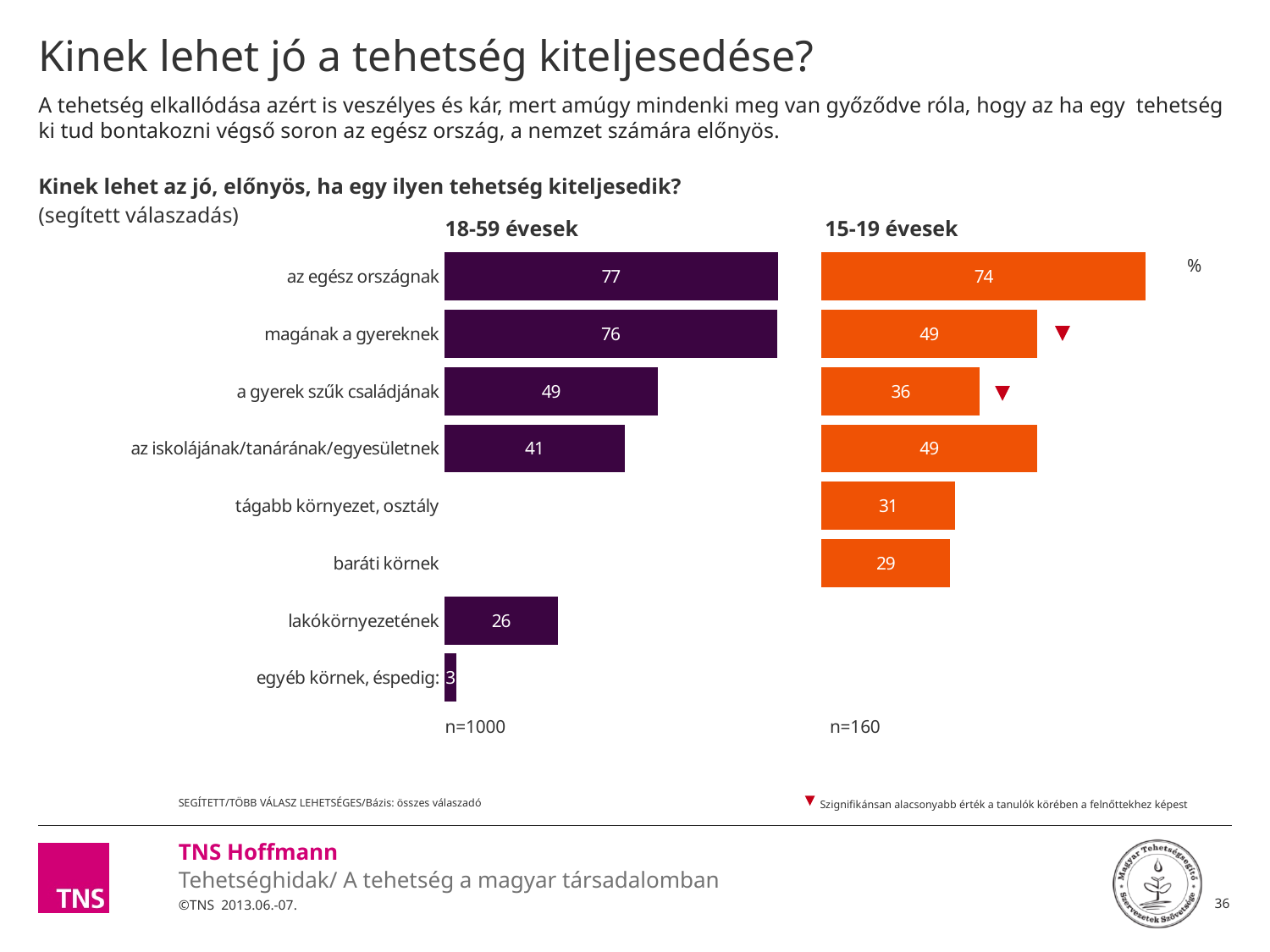
In the 15-19 évesek chart, which category has the highest value? az egész országnak In the 18-59 évesek chart, what is the value for 'az egész országnak'? 77 For 'az iskolájának/tanárának/egyesületnek', which group has the larger value, 18-59 évesek or 15-19 évesek? 15-19 évesek What kind of chart is used on this slide? bar chart What is the sample size (n) shown under the 15-19 évesek chart? n=160 In the 18-59 évesek chart, what is the difference between 'a gyerek szűk családjának' and 'az iskolájának/tanárának/egyesületnek'? 8 What is the difference between the 18-59 évesek and 15-19 évesek values for 'magának a gyereknek'? 27 In the 15-19 évesek chart, what is the value for 'baráti körnek'? 29 In the 15-19 évesek chart, how many categories have a bar with a value shown? 6 In the 18-59 évesek chart, what is the value for 'lakókörnyezetének'? 26 In the 18-59 évesek chart, which category has the lowest value? egyéb körnek, éspedig: In the 15-19 évesek chart, what is the value for 'a gyerek szűk családjának'? 36